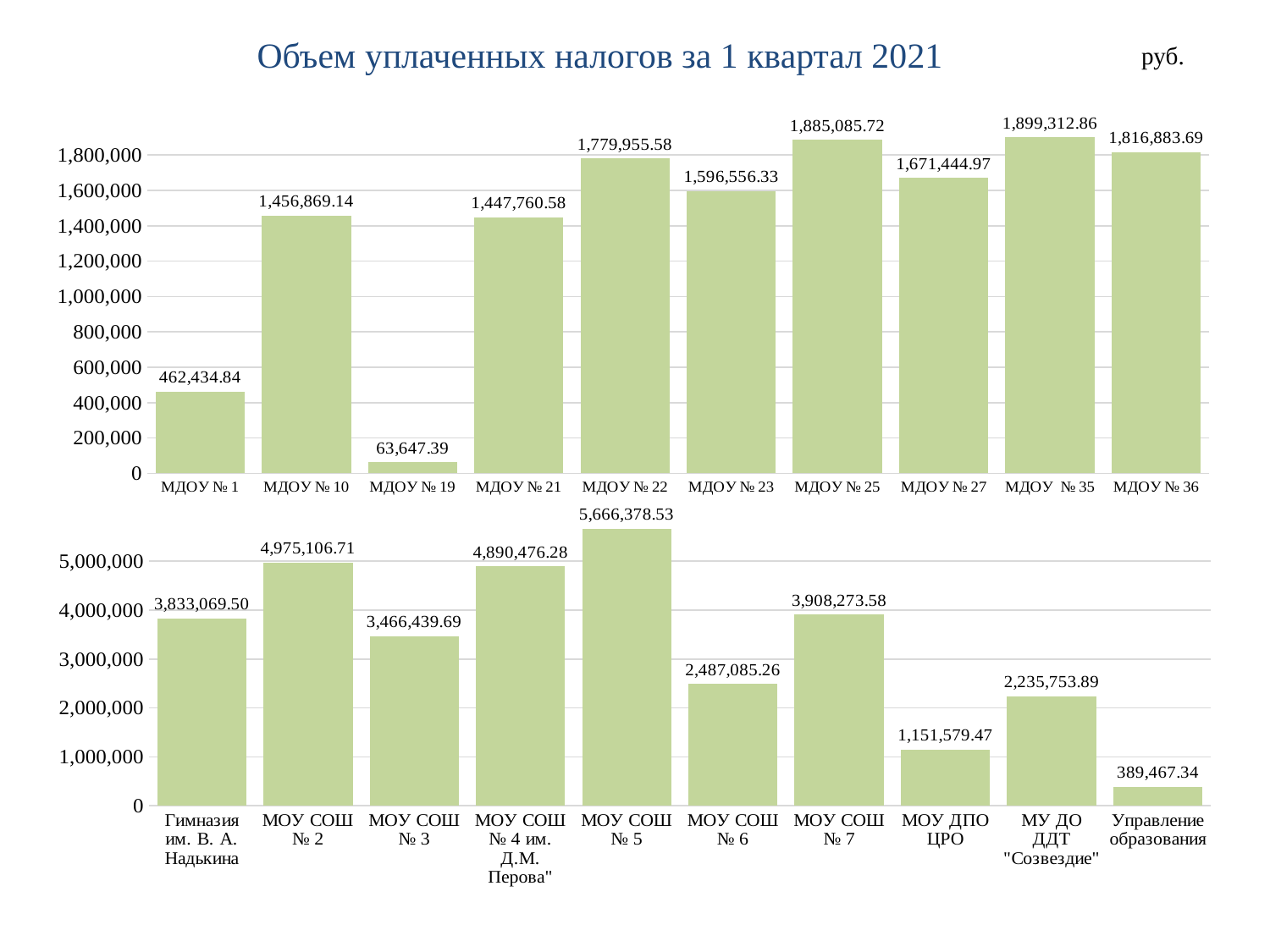
In the bottom chart, which is larger: the value for МОУ СОШ № 7 or the value for МОУ СОШ № 6? МОУ СОШ № 7 In the bottom chart, which category has the lowest value? Управление образования How many categories are shown in the top chart? 10 In the top chart, what is the difference between the values for МДОУ № 22 and МДОУ № 21? 332,195.00 In the top chart, what is the value for МДОУ № 22? 1,779,955.58 In the bottom chart, what is the value for МОУ ДПО ЦРО? 1,151,579.47 In the top chart, which category has the lowest value? МДОУ № 19 What kind of chart is the bottom chart? Bar chart What is the title shown at the top of the slide? Объем уплаченных налогов за 1 квартал 2021 In the bottom chart, which category has the highest value? МОУ СОШ № 5 In the top chart, which category has the highest value? МДОУ № 35 In the bottom chart, what is the difference between the values for МОУ СОШ № 2 and МОУ СОШ № 3? 1,508,667.02